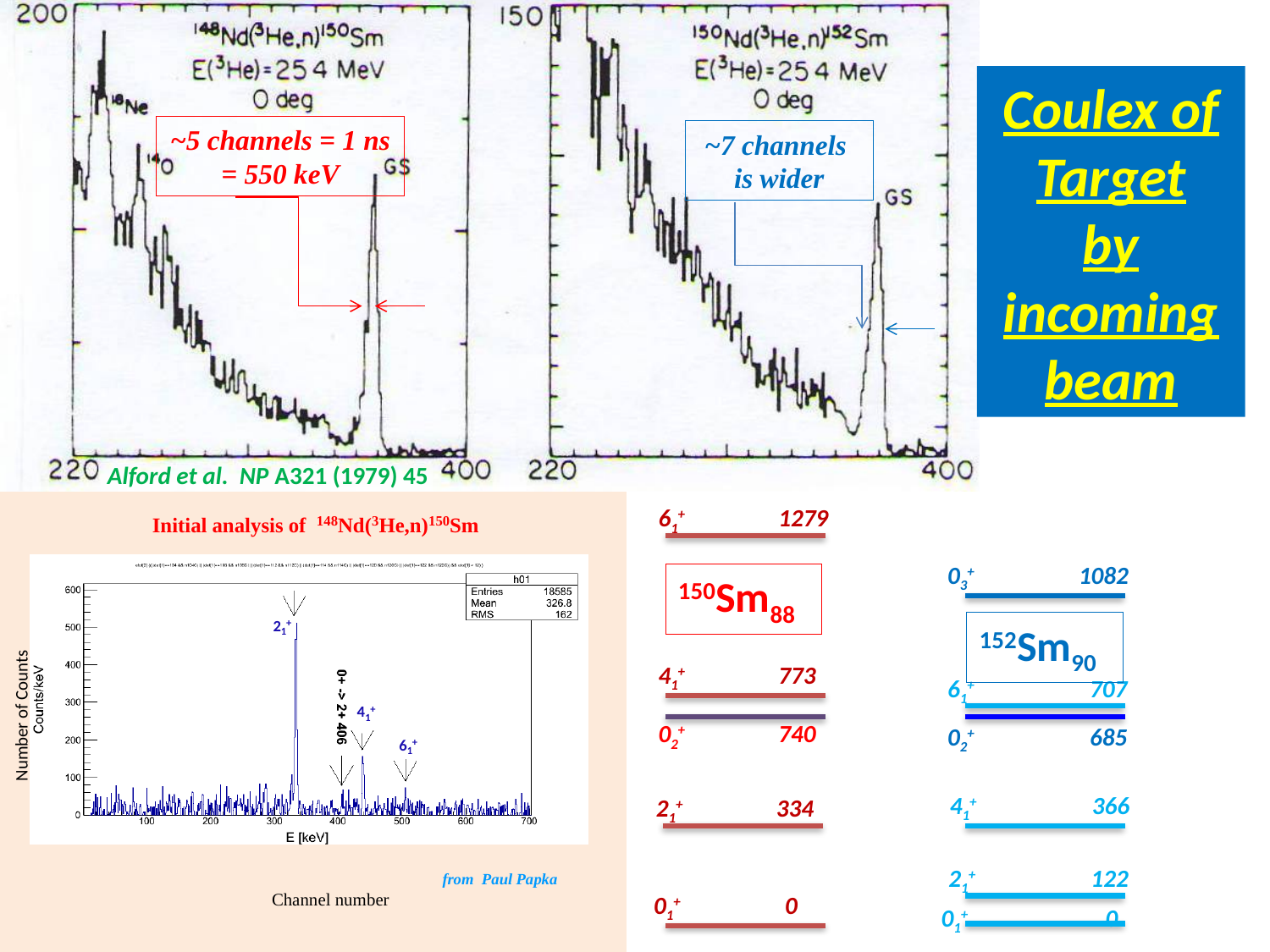
According to the annotation on the top-left spectrum, 1 ns corresponds to how many keV? 550 keV In the bottom-left histogram, what is the RMS value shown in the statistics box? 162 In the top-left spectrum (148Nd(3He,n)150Sm), what is the maximum value shown on the vertical axis? 200 In the 150Sm88 level scheme, what is the energy of the 4_1+ level? 773 In the bottom-left histogram, is the height of the 2_1+ peak greater or less than 400 counts? greater In the bottom-left histogram, which labeled peak is the highest? 2_1+ In the 152Sm90 level scheme, what is the difference in energy between the 6_1+ level and the 0_2+ level? 22 In the top-right spectrum (150Nd(3He,n)152Sm), what is the maximum value shown on the vertical axis? 150 In the bottom-left histogram, how many entries are listed in the statistics box? 18585 In the bottom-left histogram, what is the label of the x axis? E [keV] In the bottom-left histogram, what is the mean value shown in the statistics box? 326.8 In the bottom-left histogram, is the height of the 4_1+ peak greater or less than 300 counts? less